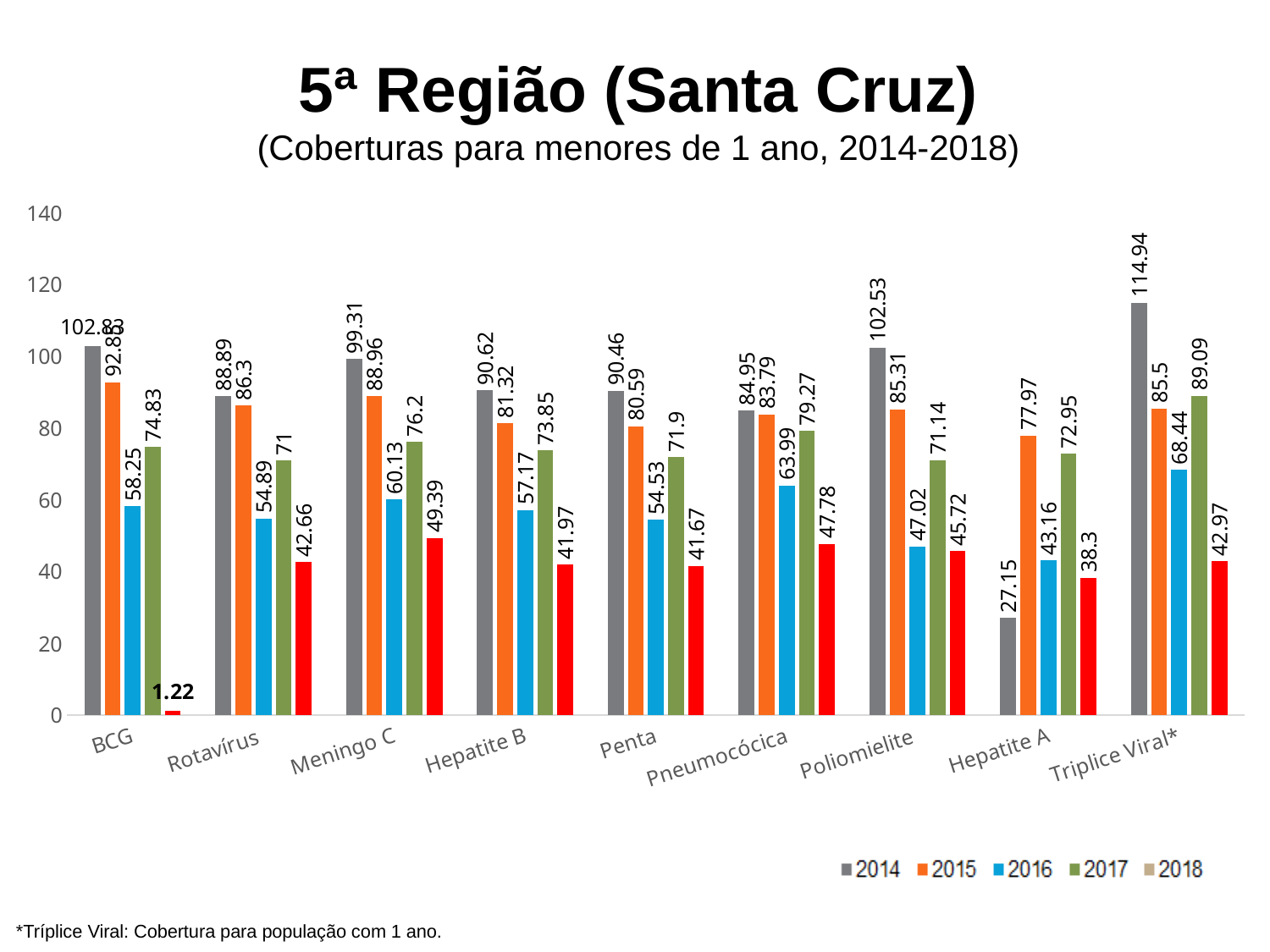
Which category has the lowest 2018 value? BCG Which category has the highest 2014 value? Tríplice Viral* What is the 2017 value for Meningo C? 76.2 How many series does the legend list? 5 What kind of chart is shown on the slide? Bar chart Which category has the lowest 2014 value? Hepatite A How many vaccine categories are shown on the x axis? 9 What is the 2016 value for Tríplice Viral*? 68.44 Which is larger, the 2016 value for Pneumocócica or the 2016 value for Hepatite B? Pneumocócica What is the difference between the 2014 and 2018 values for Poliomielite? 56.81 What is the 2015 value for Hepatite A? 77.97 What colour represents the 2016 series in the legend? Blue